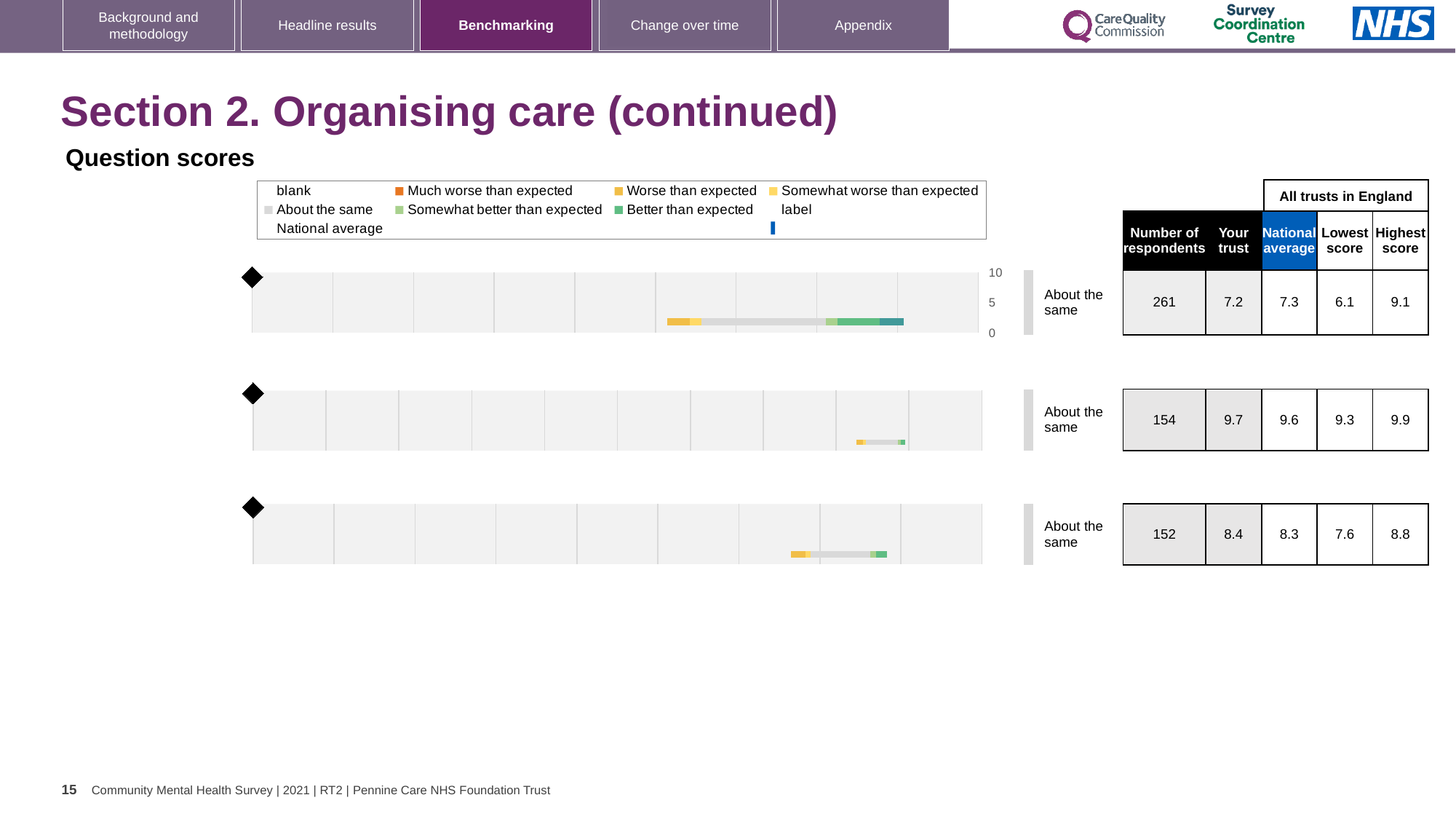
How many benchmarking charts are shown on the slide? 3 For the top chart, what is the 'Your trust' score shown in the table beside it? 7.2 For the top chart, what is the national average score shown in the table beside it? 7.3 What kind of chart is used for the three benchmarking charts on this slide? bar chart For the top chart, which is larger: the 'Your trust' score or the national average? National average For the bottom chart, what is the difference between the highest score and the lowest score in the table beside it? 1.2 For the middle chart, what is the difference between the highest score and the lowest score in the table beside it? 0.6 In the legend, what colour represents 'Much worse than expected'? orange Which of the three charts has the highest 'Your trust' score? the middle chart For the middle chart, how many respondents are shown in the table beside it? 154 For the bottom chart, what is the highest score shown in the table beside it? 8.8 Which of the three charts has the lowest number of respondents? the bottom chart